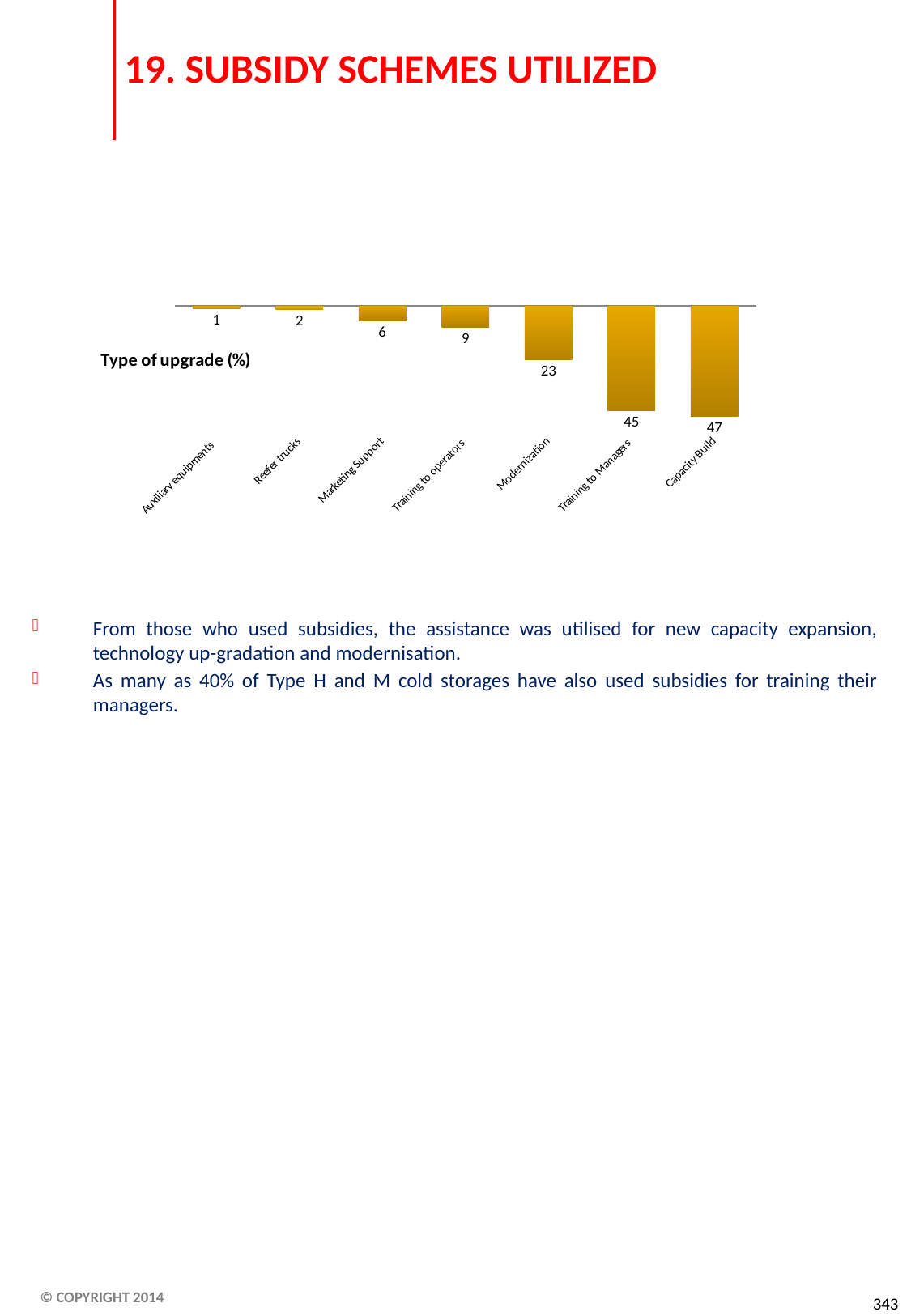
What is the value for Reefer trucks in the Type of upgrade (%) chart? 2 Which category has the highest value in the Type of upgrade (%) chart? Capacity Build What is the difference between the values for Capacity Build and Training to Managers? 2 What is the value for Training to Managers in the Type of upgrade (%) chart? 45 Which is larger, the value for Marketing Support or the value for Training to operators? Training to operators What is the difference between the values for Modernization and Marketing Support? 17 What kind of chart is shown on the slide? Bar chart What is the value for Training to operators in the Type of upgrade (%) chart? 9 What is the value for Modernization in the Type of upgrade (%) chart? 23 How many categories are shown in the Type of upgrade (%) chart? 7 Which category has the lowest value in the Type of upgrade (%) chart? Auxiliary equipments Do the values rise or fall moving from left to right across the categories in the chart? Rise